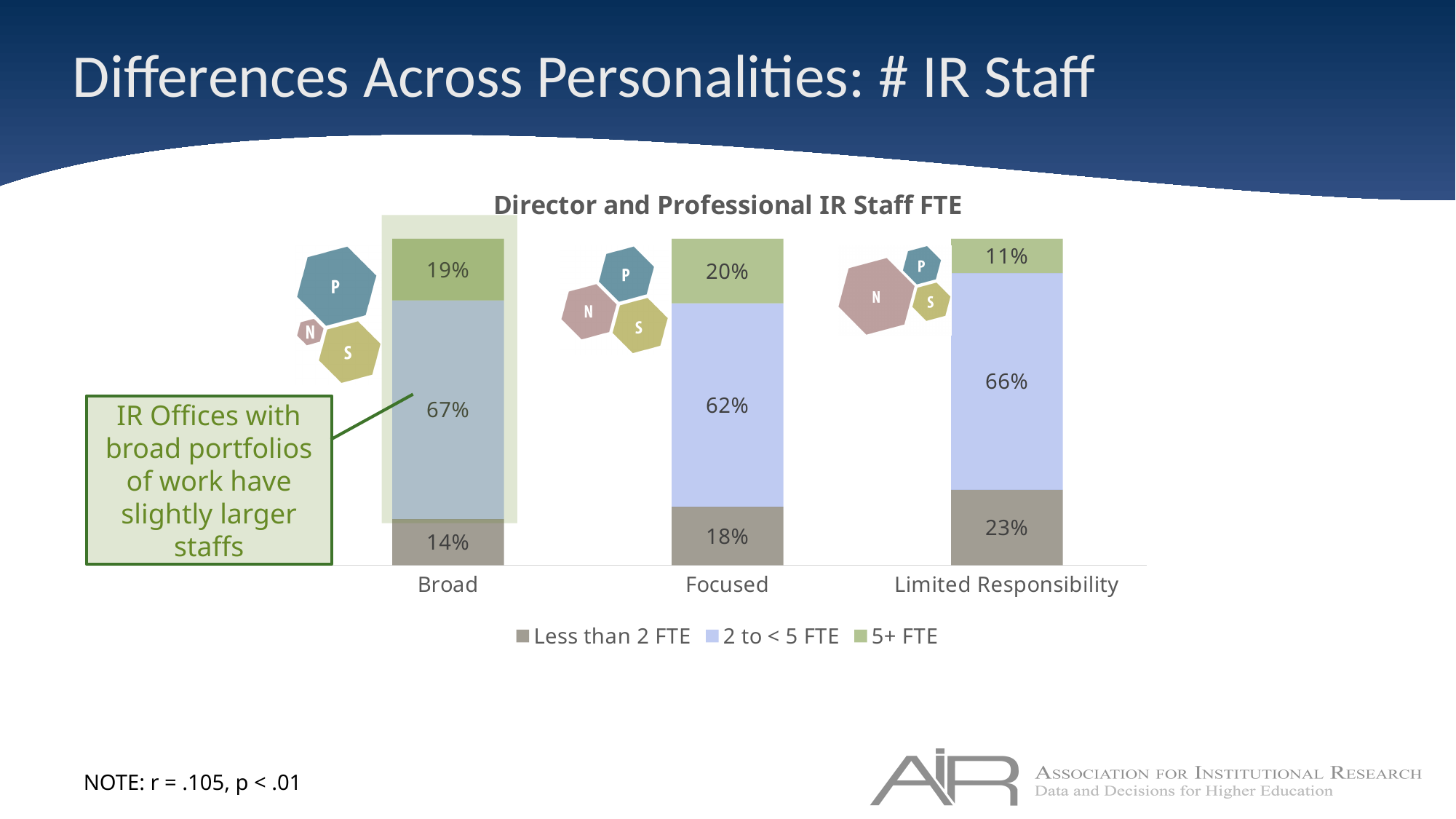
What is the total of the stacked bar for Focused? 100% Which is larger: the 5+ FTE value for Broad or for Limited Responsibility? Broad How many categories are shown on the x axis? 3 What kind of chart is shown on the slide? Stacked bar chart How many series does the legend list? 3 What is the value for Less than 2 FTE in the Limited Responsibility category? 23% Which category has the highest value for 5+ FTE? Focused What is the title of the chart? Director and Professional IR Staff FTE What is the value for 2 to < 5 FTE in the Focused category? 62% Which category has the lowest value for Less than 2 FTE? Broad What is the difference between the 2 to < 5 FTE values for Limited Responsibility and Broad? 1% What is the value for 5+ FTE in the Broad category? 19%